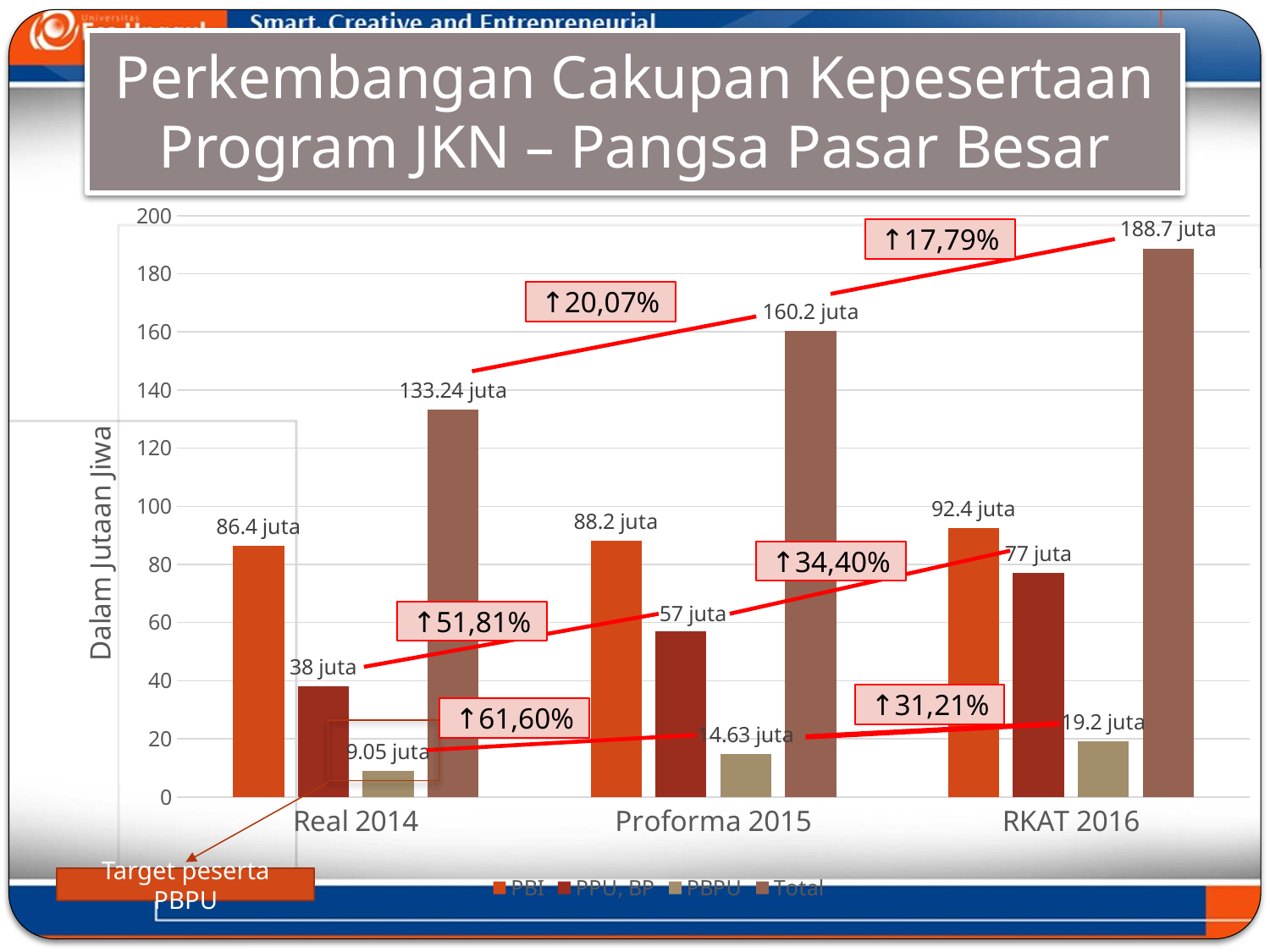
Which category has the lowest PBPU value? Real 2014 What is the difference between the Total values for RKAT 2016 and Proforma 2015? 28.5 juta What is the PPU, BP value for Proforma 2015? 57 juta What is the PBPU value for RKAT 2016? 19.2 juta What is the PBI value for Real 2014? 86.4 juta How many series does the legend list? 4 How many categories are shown on the x axis? 3 Do the Total values rise or fall from Real 2014 to RKAT 2016? Rise What is the Total value for Proforma 2015? 160.2 juta What kind of chart is shown on the slide? Bar chart Which is larger, the PPU, BP value for RKAT 2016 or the PBI value for Real 2014? PBI value for Real 2014 Which category has the highest Total value? RKAT 2016